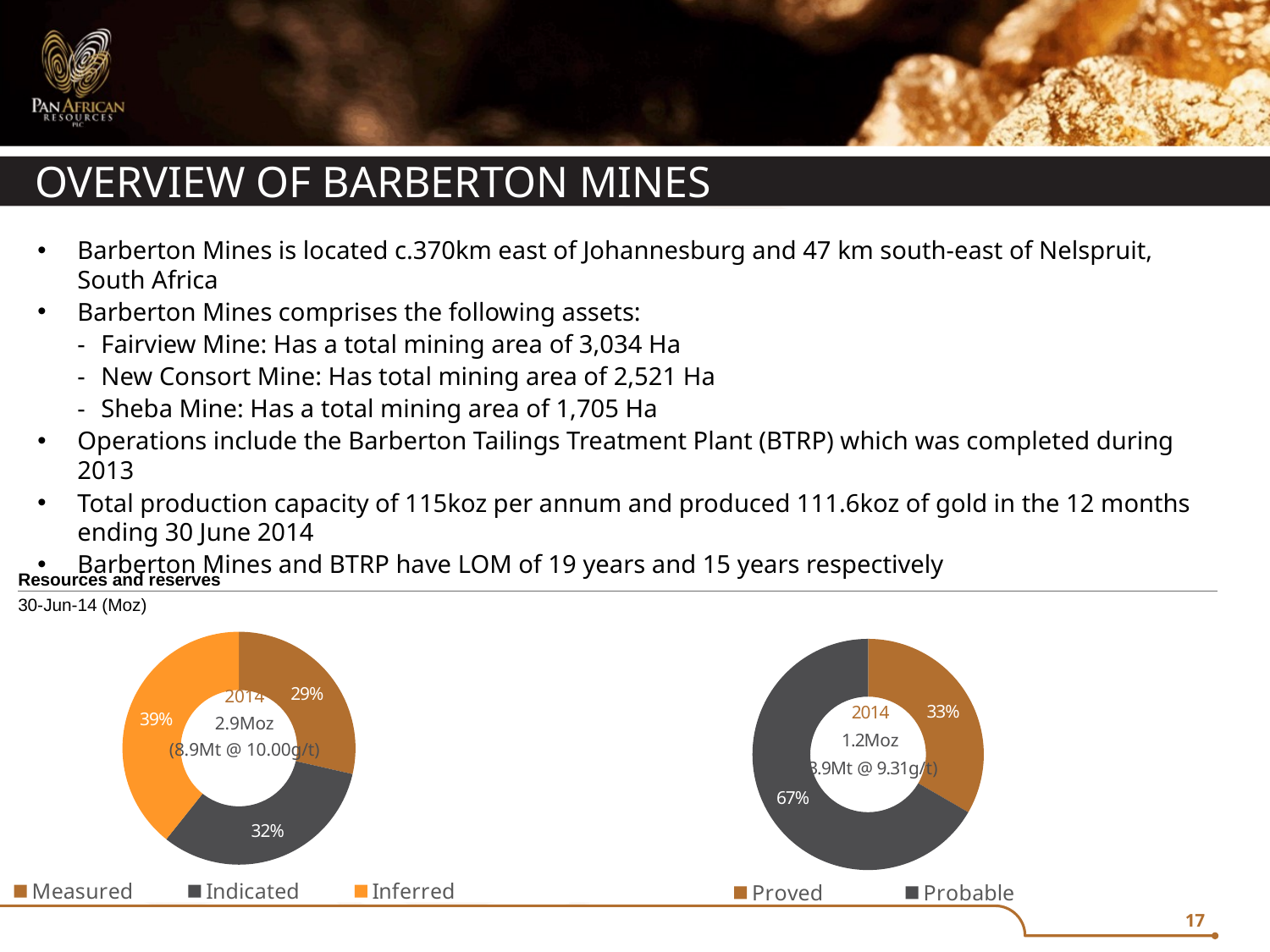
What type of chart is the right chart? Doughnut chart In the left chart, what percentage is shown for Inferred? 39% In the left chart, which is larger, Inferred or Indicated? Inferred In the right chart, what is the difference in percentage points between Probable and Proved? 34 In the right chart, what percentage is shown for Proved? 33% How many categories does the left chart show? 3 In the left chart, what percentage is shown for Indicated? 32% How many entries does the legend of the right chart list? 2 In the left chart, what percentage is shown for Measured? 29% In the left chart, which category has the largest share? Inferred In the left chart, which category has the smallest share? Measured In the right chart, what percentage is shown for Probable? 67%